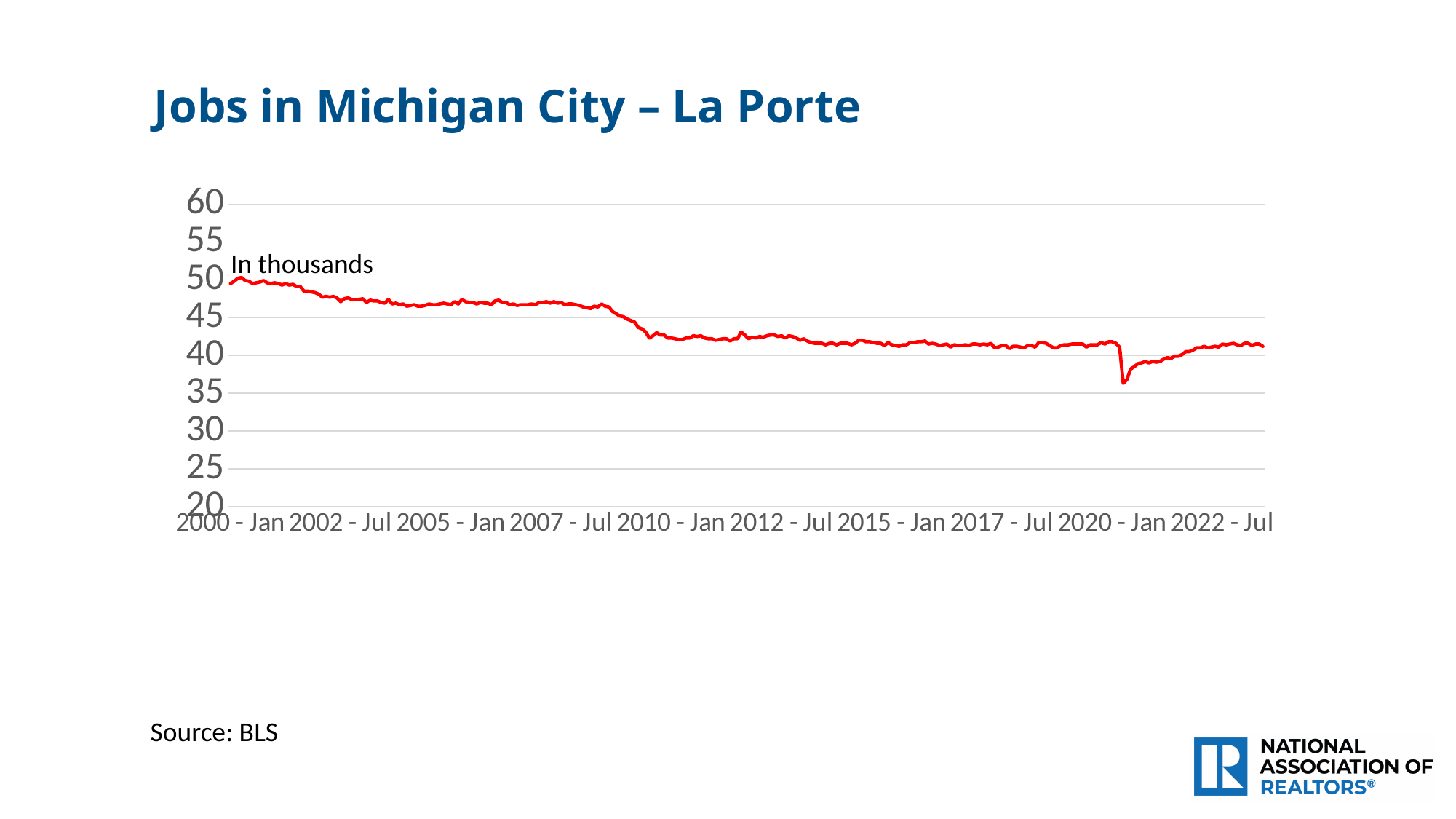
What is the title of the chart? Jobs in Michigan City – La Porte Is the value at 2005 - Jan greater or less than 50? less Is the value at 2015 - Jan greater or less than 45? less Overall, do the values rise or fall from 2000 - Jan to 2022 - Jul? fall Which is larger, the value at 2000 - Jan or the value at 2012 - Jul? 2000 - Jan In what units are the values on the chart expressed, according to the annotation? In thousands How many lines are plotted on the chart? 1 Around which year does the line reach its lowest point? 2020 What kind of chart is shown on the slide? line chart Is the value at 2010 - Jan greater or less than 45? less